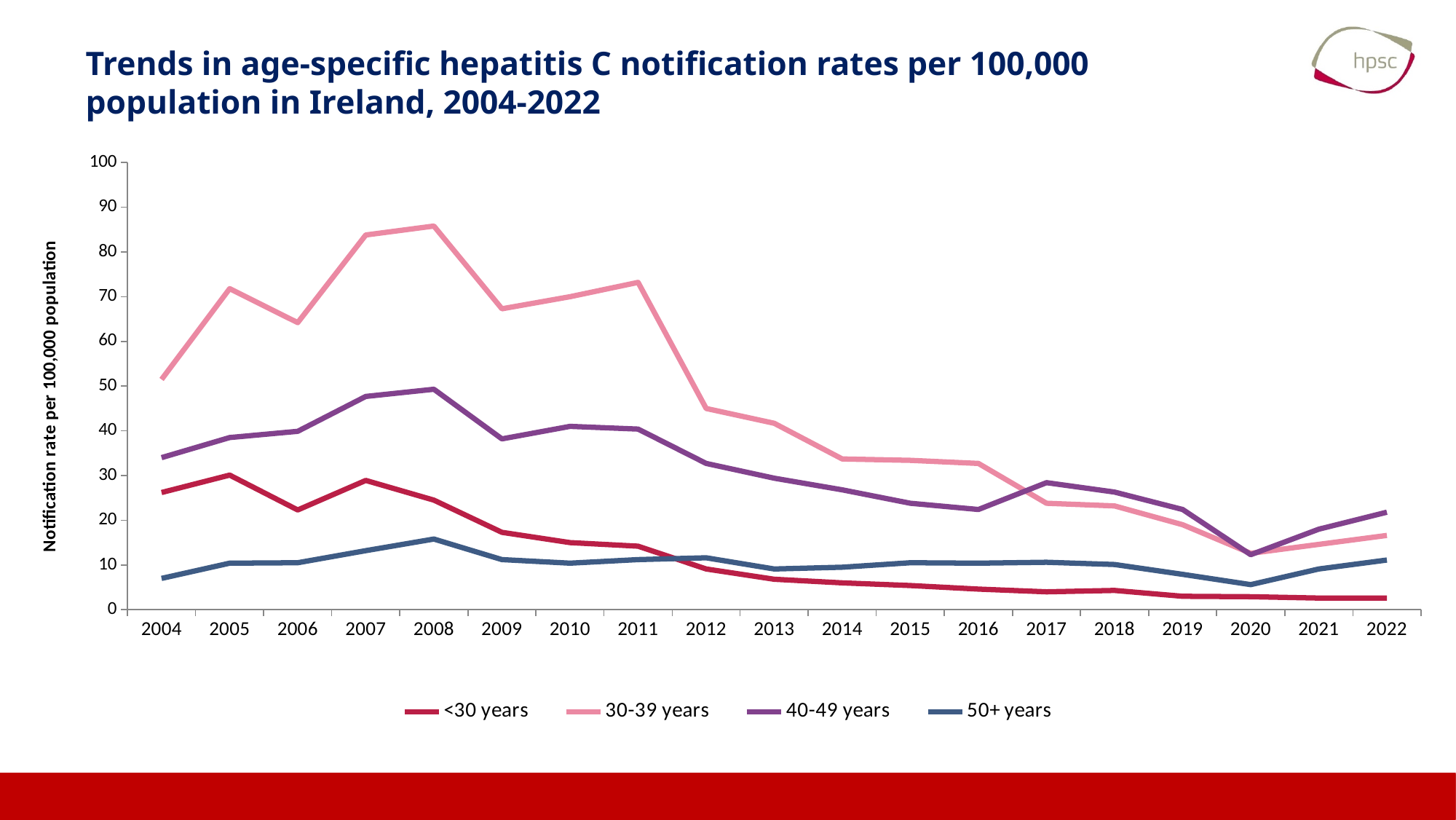
Is the value for 40-49 years in 2020 greater or less than 20? less Is the value for 30-39 years in 2008 greater or less than 80? greater In 2017, which is higher: the 40-49 years series or the 30-39 years series? 40-49 years Is the value for <30 years in 2022 greater or less than 10? less How many years are shown along the x axis? 19 How many series does the legend list? 4 Which age group has the highest notification rate in 2008? 30-39 years In which year does the 30-39 years series reach its highest value? 2008 What is the label on the y axis? Notification rate per 100,000 population What kind of chart is shown on the slide? line chart Does the <30 years series rise or fall from 2011 to 2022? fall Which age group has the lowest notification rate in 2004? 50+ years